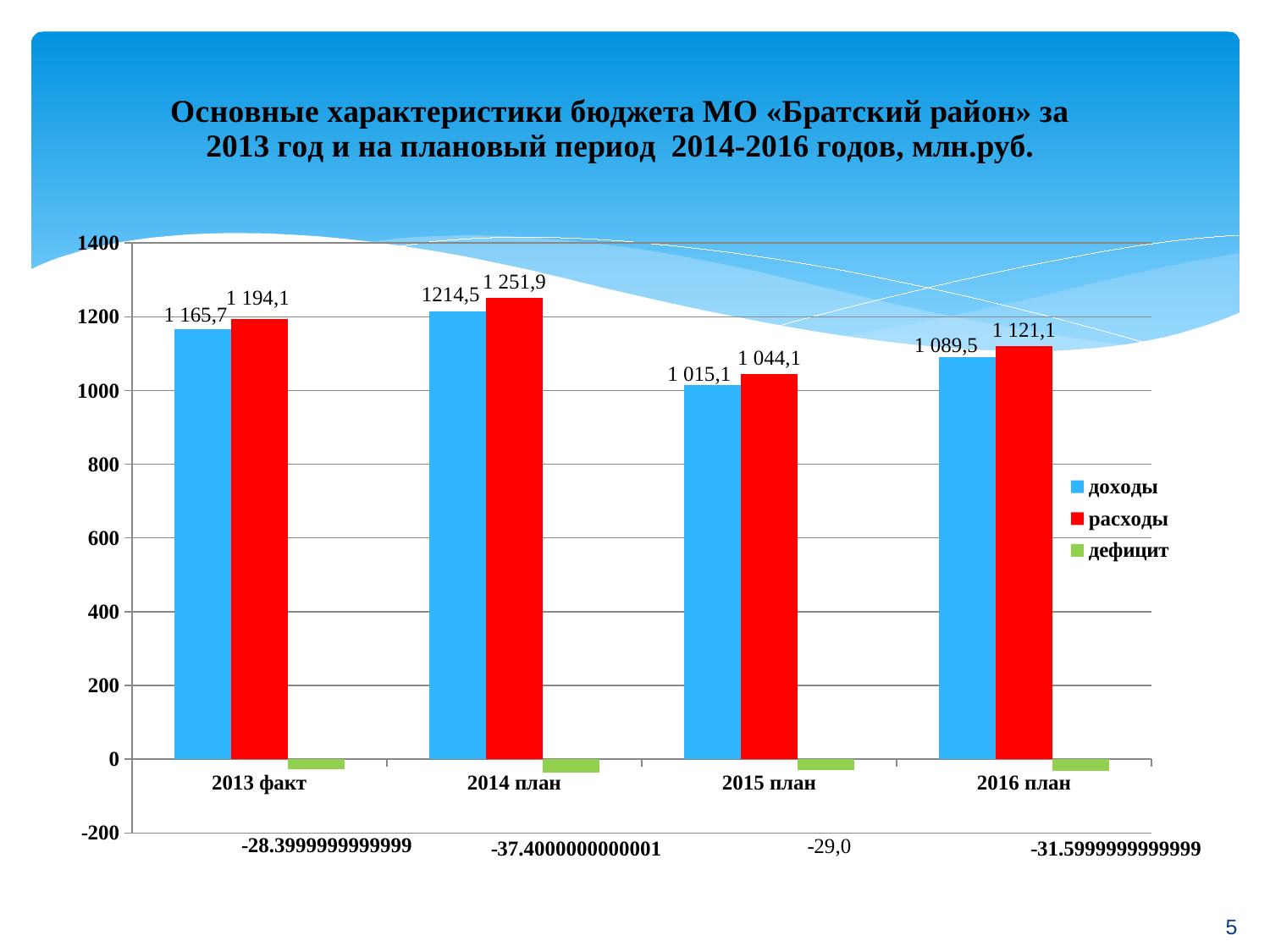
How many categories are shown on the x axis? 4 Which is larger for 2016 план: доходы or расходы? расходы What is the difference between расходы and доходы for 2015 план? 29,0 Which series is shown in red in the legend? расходы What type of chart is shown on the slide? bar chart What is the value of расходы for 2014 план? 1 251,9 What is the value of доходы for 2016 план? 1 089,5 How many series does the legend list? 3 What is the value of дефицит for 2015 план? -29,0 What is the value of доходы for 2013 факт? 1 165,7 In which category are доходы the highest? 2014 план In which category are расходы the lowest? 2015 план